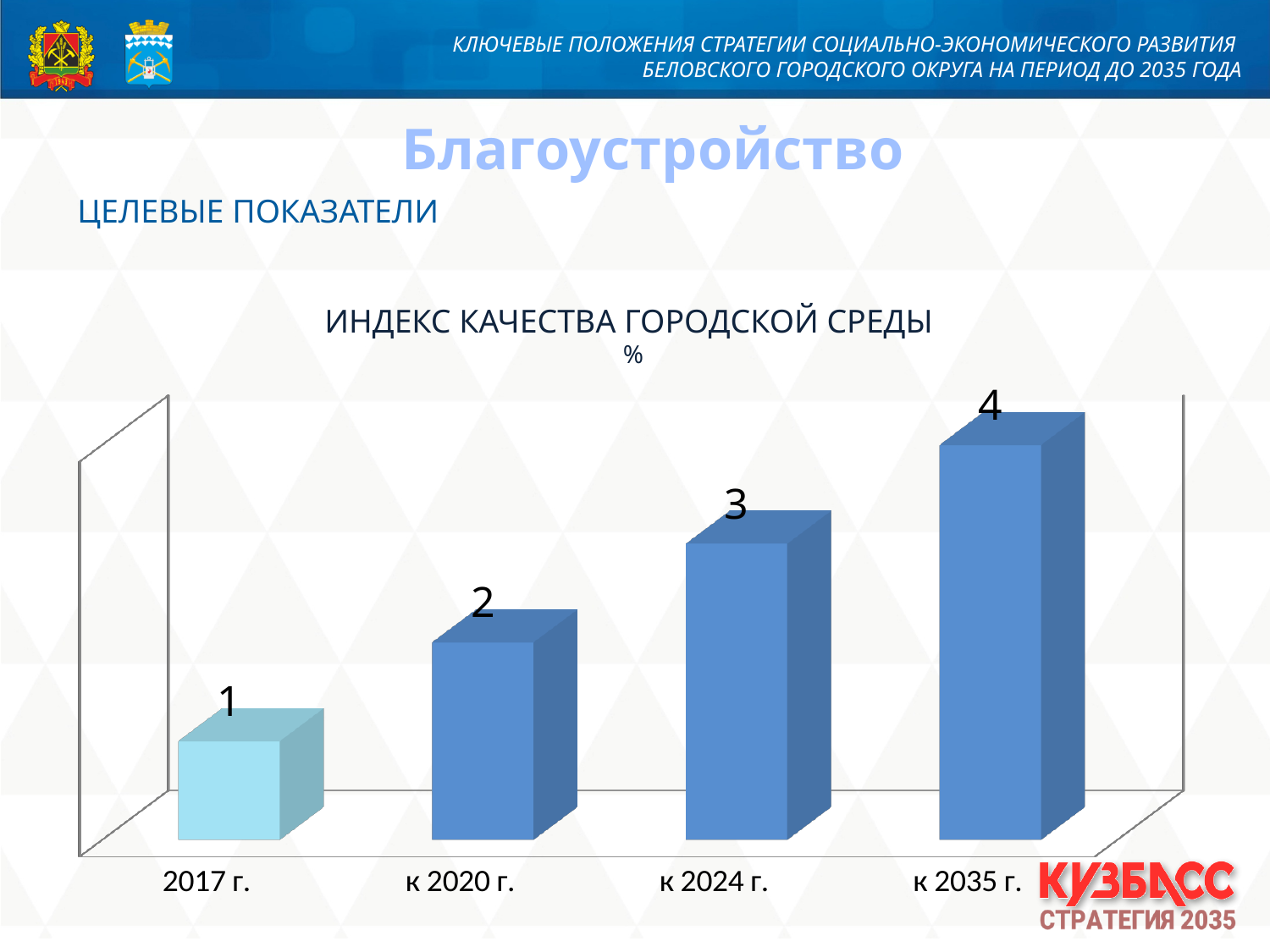
Do the values rise or fall from 2017 г. to к 2035 г.? rise What is the value for 2017 г.? 1 What is the title of the chart? ИНДЕКС КАЧЕСТВА ГОРОДСКОЙ СРЕДЫ Which category has the highest value? к 2035 г. What is the difference between the values for к 2035 г. and 2017 г.? 3 How many categories are shown on the chart? 4 What is the value for к 2024 г.? 3 Which category has the lowest value? 2017 г. What is the value for к 2020 г.? 2 Which is larger, the value for к 2024 г. or the value for к 2020 г.? к 2024 г. What is the value for к 2035 г.? 4 What kind of chart is this? bar chart